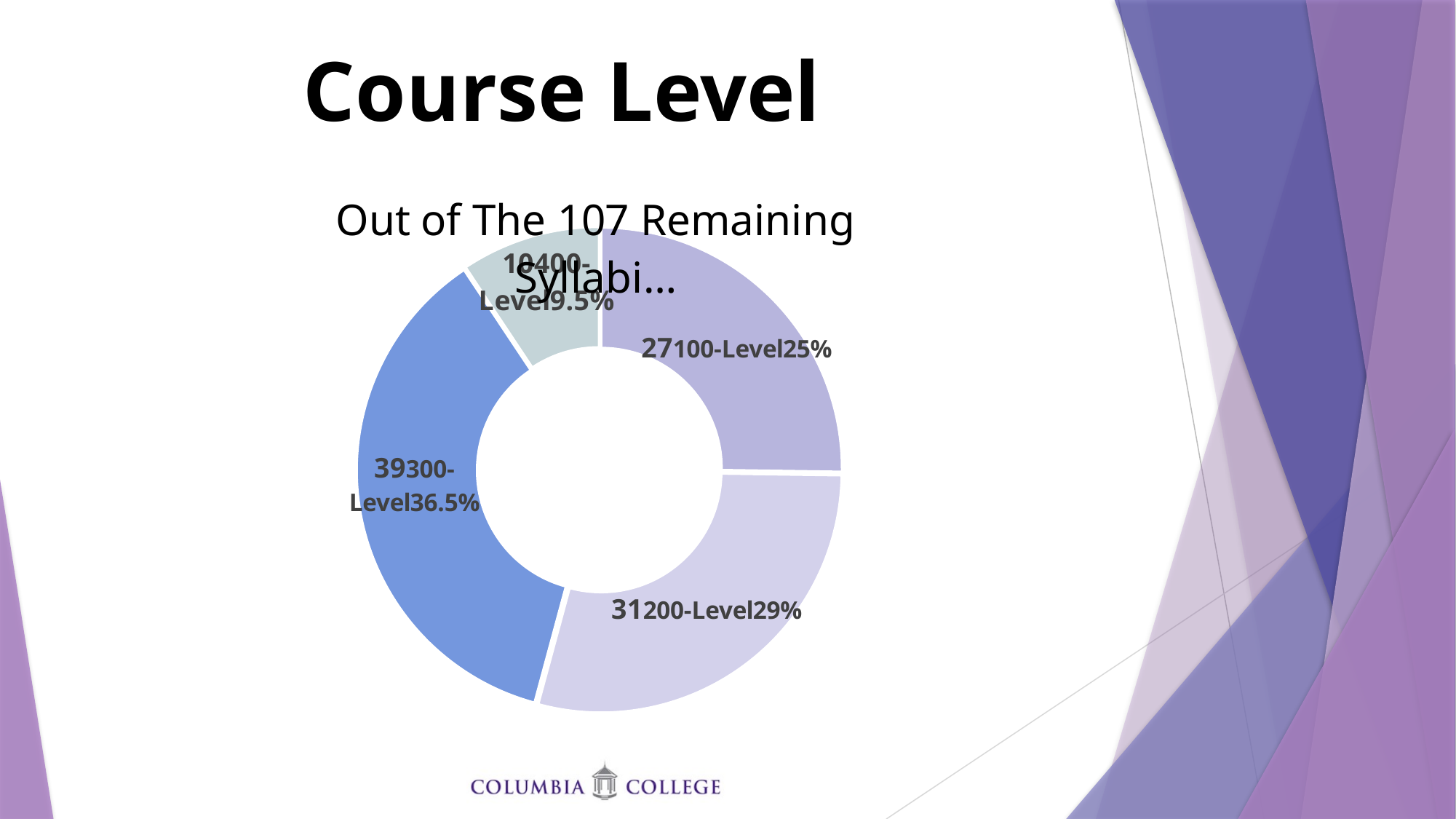
How many course-level categories does the chart show? 4 Which has a larger share of the syllabi, 100-Level or 200-Level courses? 200-Level What percentage of the syllabi are 300-Level courses? 36.5% What percentage of the syllabi are 100-Level courses? 25% What is the title of the chart? Out of The 107 Remaining Syllabi... How many syllabi are 200-Level courses? 31 How many more syllabi are 300-Level than 100-Level? 12 Which course level has the smallest share of the syllabi? 400-Level What kind of chart is shown on the slide? Doughnut (pie) chart Which course level has the largest share of the syllabi? 300-Level How many syllabi are 300-Level courses? 39 What percentage of the syllabi are 200-Level courses? 29%